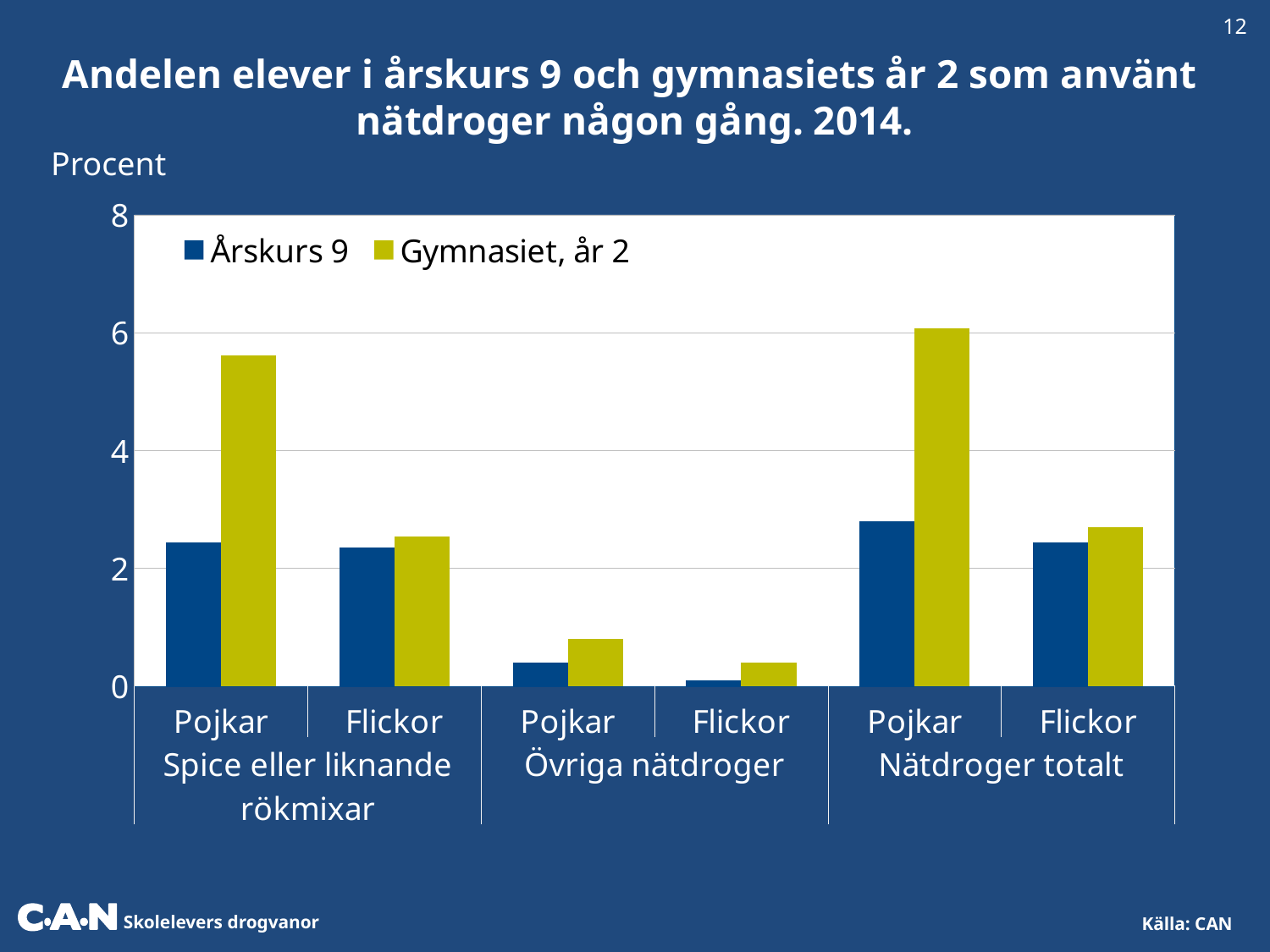
What kind of chart is shown on the slide? bar chart Is the Gymnasiet, år 2 value for Pojkar under Nätdroger totalt greater or less than 4? greater Is the Gymnasiet, år 2 value for Flickor under Övriga nätdroger greater or less than 2? less How many drug categories (groups) are shown along the x axis? 3 What are the two series named in the legend? Årskurs 9 and Gymnasiet, år 2 Is the Gymnasiet, år 2 value for Pojkar under Spice eller liknande rökmixar greater or less than 4? greater For Pojkar under Nätdroger totalt, which series has the larger value, Årskurs 9 or Gymnasiet, år 2? Gymnasiet, år 2 How many series does the legend list? 2 What unit is shown on the y axis label? Procent Which bar is the highest in the chart? Gymnasiet, år 2 for Pojkar, Nätdroger totalt Which bar is the lowest in the chart? Årskurs 9 for Flickor, Övriga nätdroger